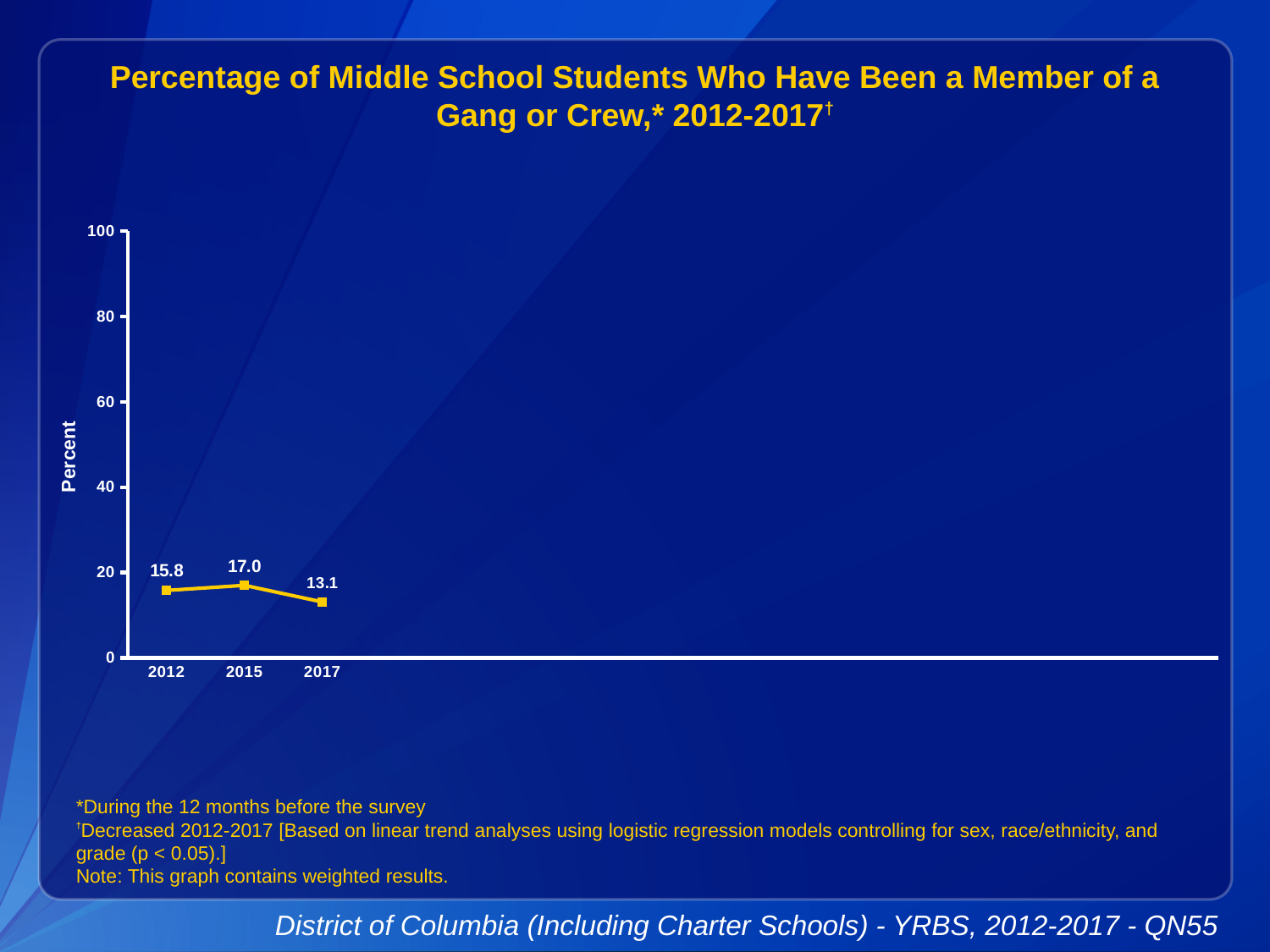
How many years are plotted on the chart? 3 What is the difference between the values for 2015 and 2017? 3.9 What is the difference between the values for 2012 and 2015? 1.2 Which year has the lowest value? 2017 What kind of chart is shown on the slide? line chart What is the value for 2017? 13.1 What is the label of the y axis? Percent What is the value for 2015? 17.0 Which year has the highest value? 2015 Is the value for 2015 greater or less than 20? less Which is larger, the value for 2012 or the value for 2017? 2012 What is the value for 2012? 15.8